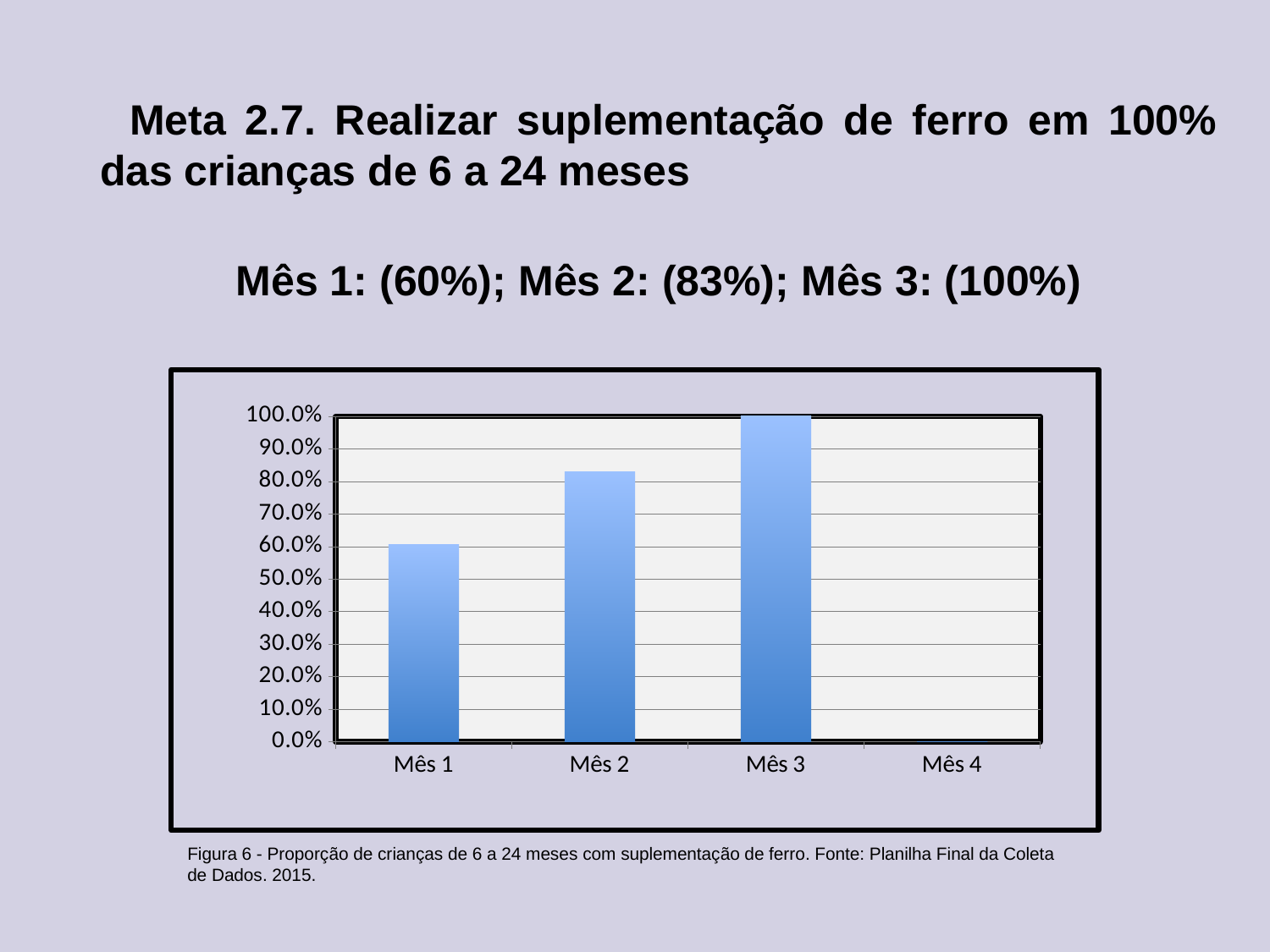
Do the bar values rise or fall from Mês 1 to Mês 3? rise What is the difference between the values for Mês 3 and Mês 1? 40% What is the difference between the values for Mês 2 and Mês 1? 23% According to the slide, what is the value for Mês 3? 100% Among Mês 1, Mês 2 and Mês 3, which has the lowest bar? Mês 1 Which month has the highest bar in the chart? Mês 3 According to the slide, what is the value for Mês 1? 60% What kind of chart is shown on the slide? bar chart According to the slide, what is the value for Mês 2? 83% How many categories are shown on the x axis of the chart? 4 Is the value for Mês 2 greater or less than 70.0%? greater Which is larger, the bar for Mês 2 or the bar for Mês 1? Mês 2